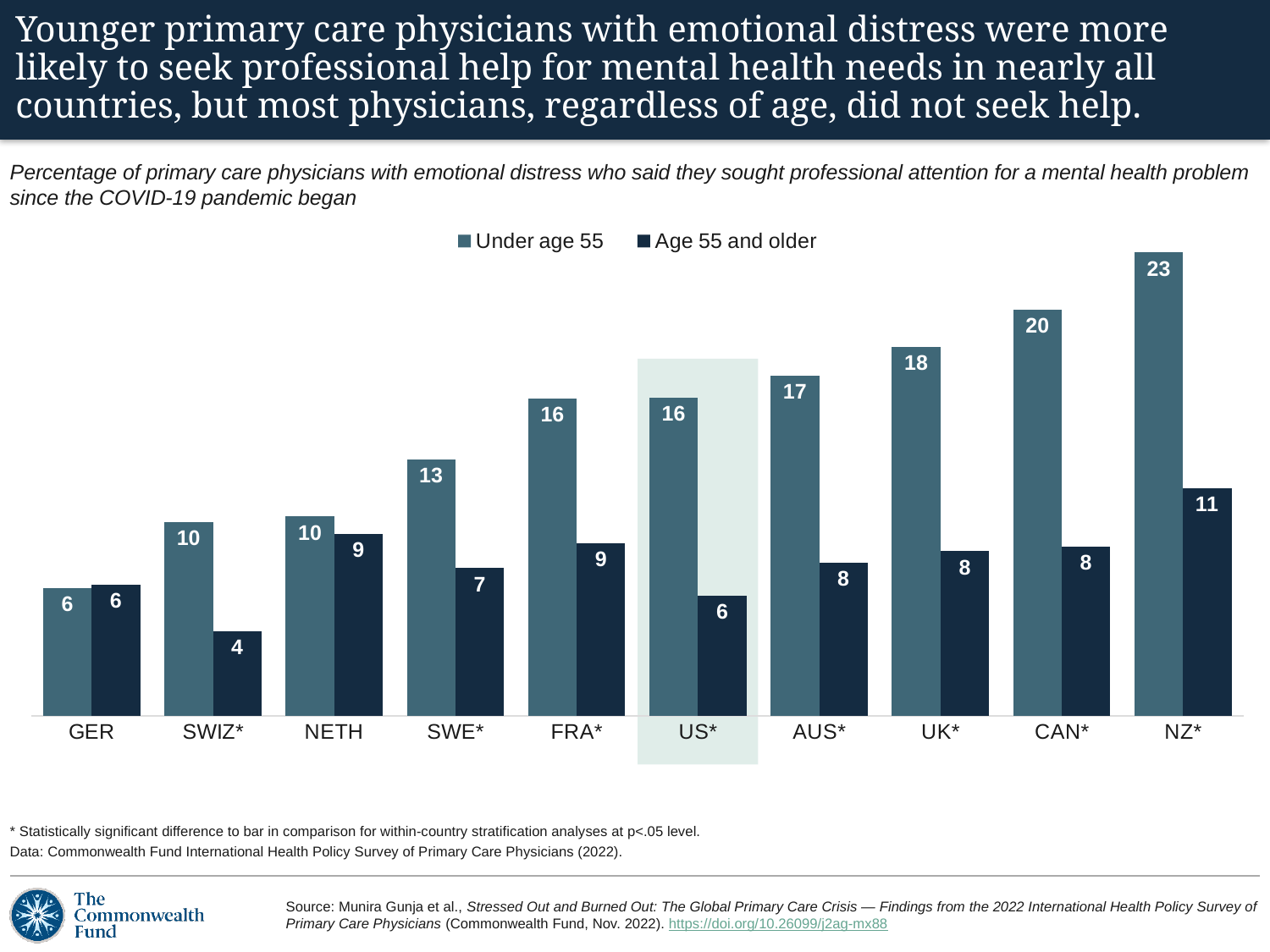
How many series does the legend list? 2 Which country has the highest value for Under age 55? NZ* Which country has the lowest value for Age 55 and older? SWIZ* What is the difference between the Under age 55 and Age 55 and older values for CAN*? 12 What is the value for Age 55 and older in SWIZ*? 4 Which is larger in NETH: the Under age 55 value or the Age 55 and older value? Under age 55 Which country is highlighted with a shaded background on the chart? US* What is the value for Under age 55 in NZ*? 23 How many countries are shown on the x axis? 10 What is the value for Age 55 and older in US*? 6 What kind of chart is shown on the slide? Bar chart Do the Under age 55 values generally rise or fall from GER to NZ* along the x axis? Rise